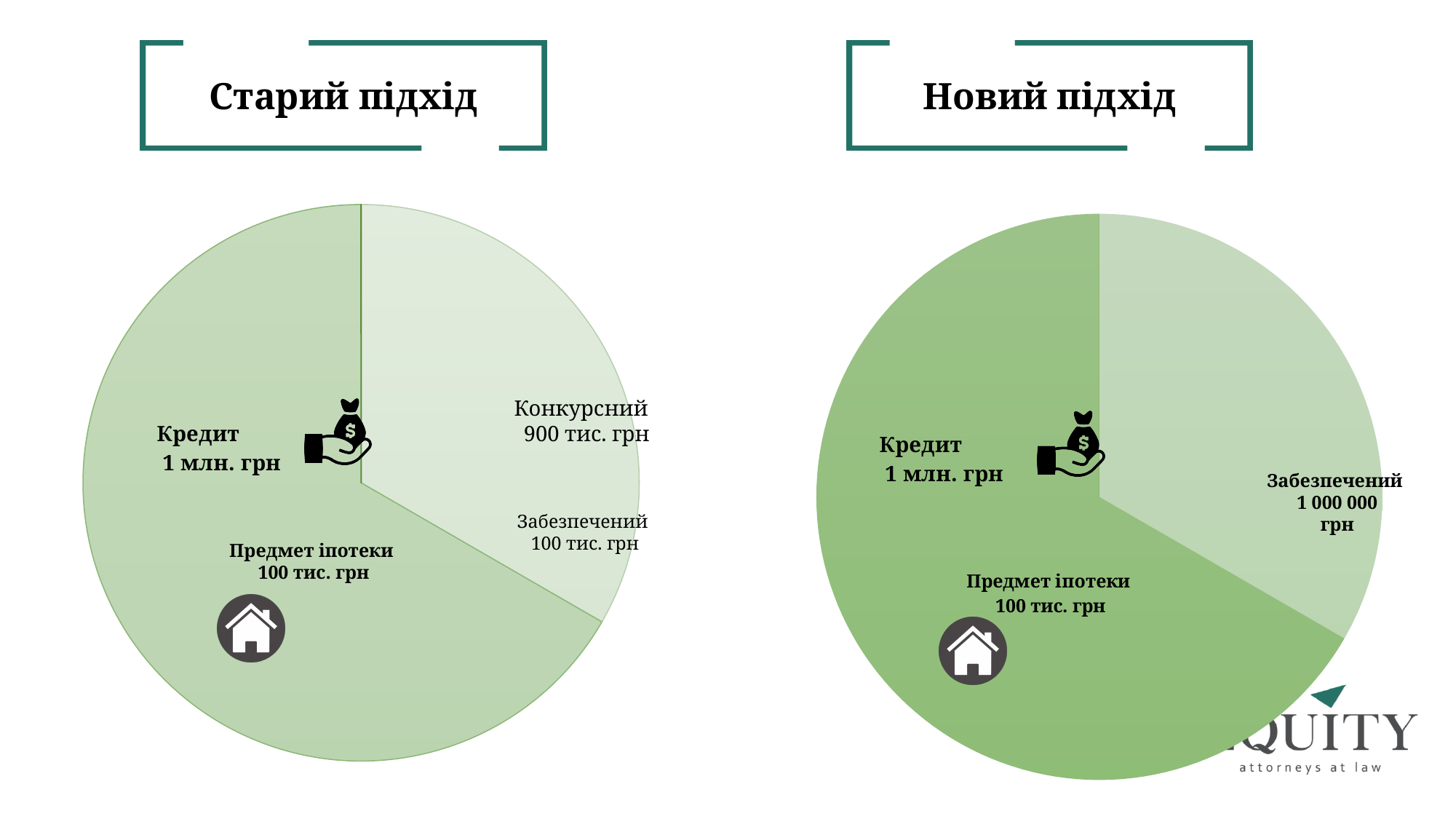
How many charts are on the slide? 2 In the "Новий підхід" chart, what is the value labelled "Кредит"? 1 млн. грн In the "Старий підхід" chart, which is larger: the "Конкурсний" value or the "Забезпечений" value? Конкурсний In the "Старий підхід" chart, what is the value labelled "Конкурсний"? 900 тис. грн In the "Новий підхід" chart, what is the value labelled "Забезпечений"? 1 000 000 грн In the "Новий підхід" chart, what is the value labelled "Предмет іпотеки"? 100 тис. грн How many slices does the "Новий підхід" pie chart have? 2 In the "Старий підхід" chart, what is the difference between the "Конкурсний" value and the "Забезпечений" value? 800 тис. грн In the "Старий підхід" chart, what is the value labelled "Забезпечений"? 100 тис. грн In the "Старий підхід" chart, what is the value labelled "Предмет іпотеки"? 100 тис. грн What kind of chart is shown under "Старий підхід"? pie chart What kind of chart is shown under "Новий підхід"? pie chart